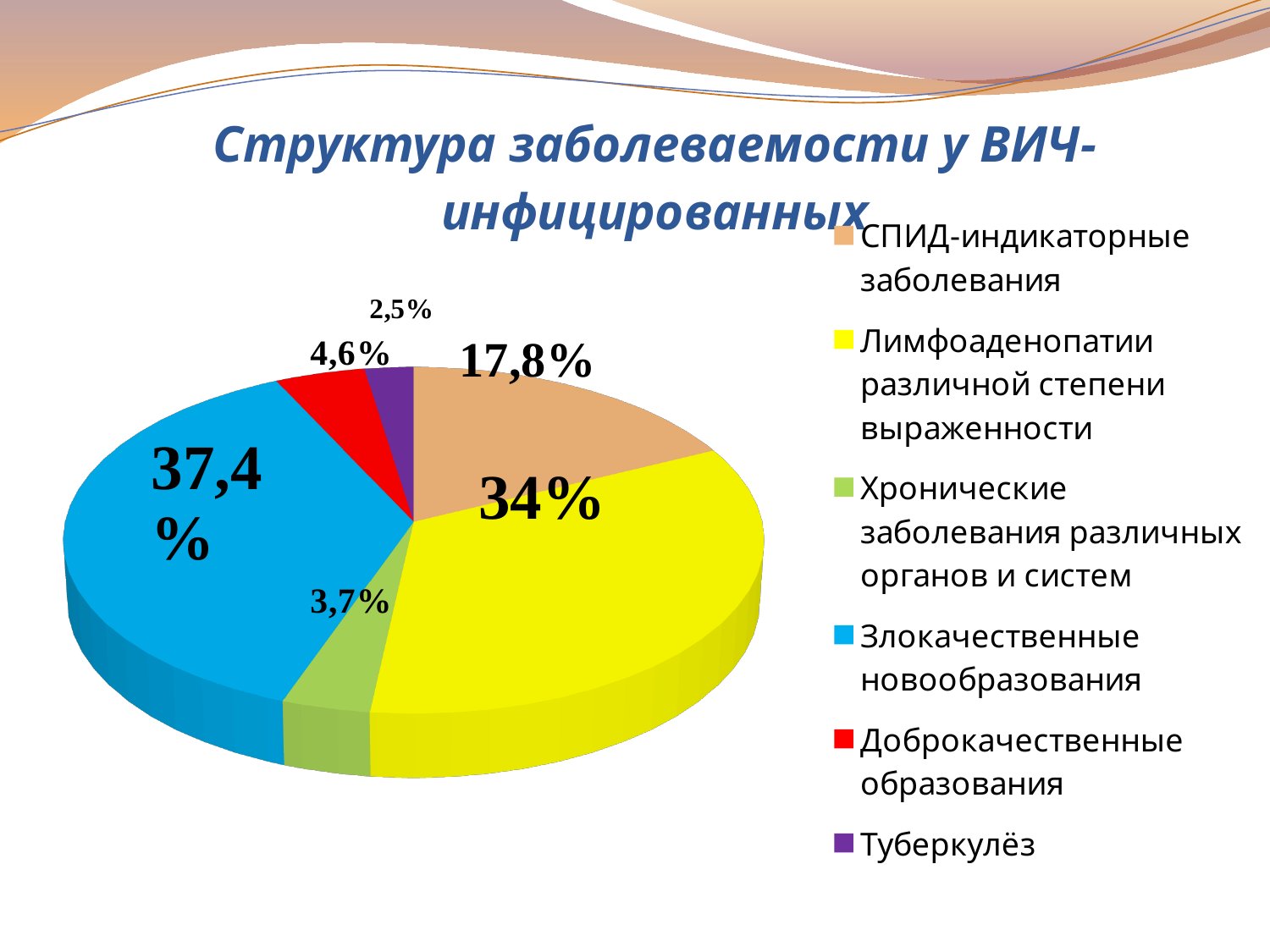
What is the share for СПИД-индикаторные заболевания? 17,8% What is the share for Туберкулёз? 2,5% What is the difference between the shares for Злокачественные новообразования and Лимфоаденопатии различной степени выраженности? 3,4% What is the share for Доброкачественные образования? 4,6% How many categories does the pie chart have? 6 What kind of chart is shown on the slide? Pie chart What is the share for Лимфоаденопатии различной степени выраженности? 34% Which category has the largest slice of the pie? Злокачественные новообразования Which is larger: the share for Доброкачественные образования or the share for Хронические заболевания различных органов и систем? Доброкачественные образования Which category has the smallest slice of the pie? Туберкулёз What is the share for Злокачественные новообразования? 37,4% What colour is the slice for Туберкулёз? Purple